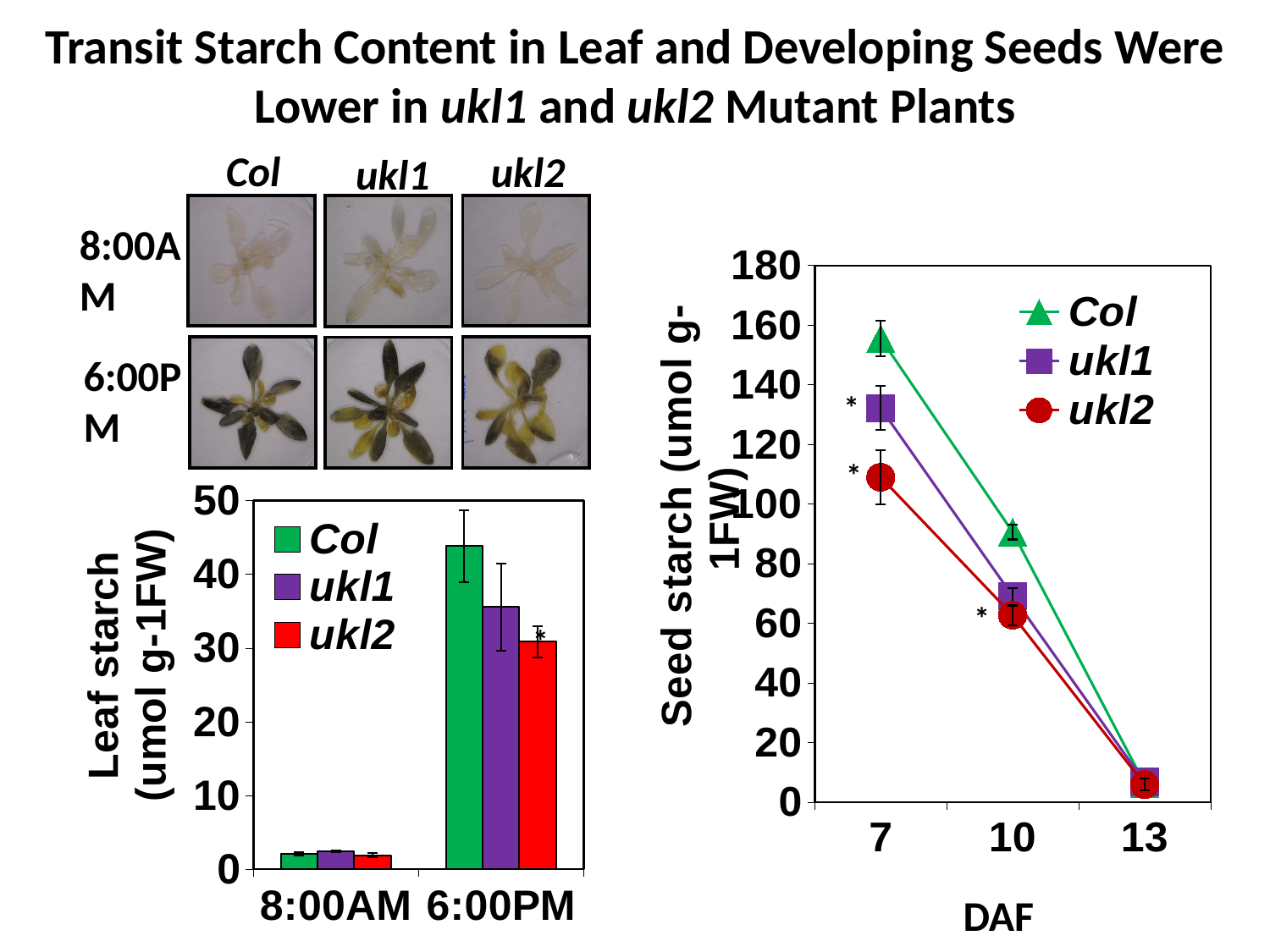
In the Leaf starch chart, which series has the highest value at 6:00PM? Col In the Seed starch chart, does the Col series rise or fall as DAF increases from 7 to 13? fall In the Seed starch chart, is the value for Col at 7 DAF greater or less than 140? greater What kind of chart is the Leaf starch chart on the left? bar chart How many time-point categories are shown on the x axis of the Leaf starch chart? 2 How many DAF points are plotted on the x axis of the Seed starch chart? 3 In the Leaf starch chart, which series has the lowest value at 6:00PM? ukl2 What kind of chart is the Seed starch chart on the right? line chart How many series does the legend of the Leaf starch chart list? 3 What is the x-axis label of the Seed starch chart? DAF In the Leaf starch chart, is the value for Col at 6:00PM greater or less than 40? greater How many series does the legend of the Seed starch chart list? 3